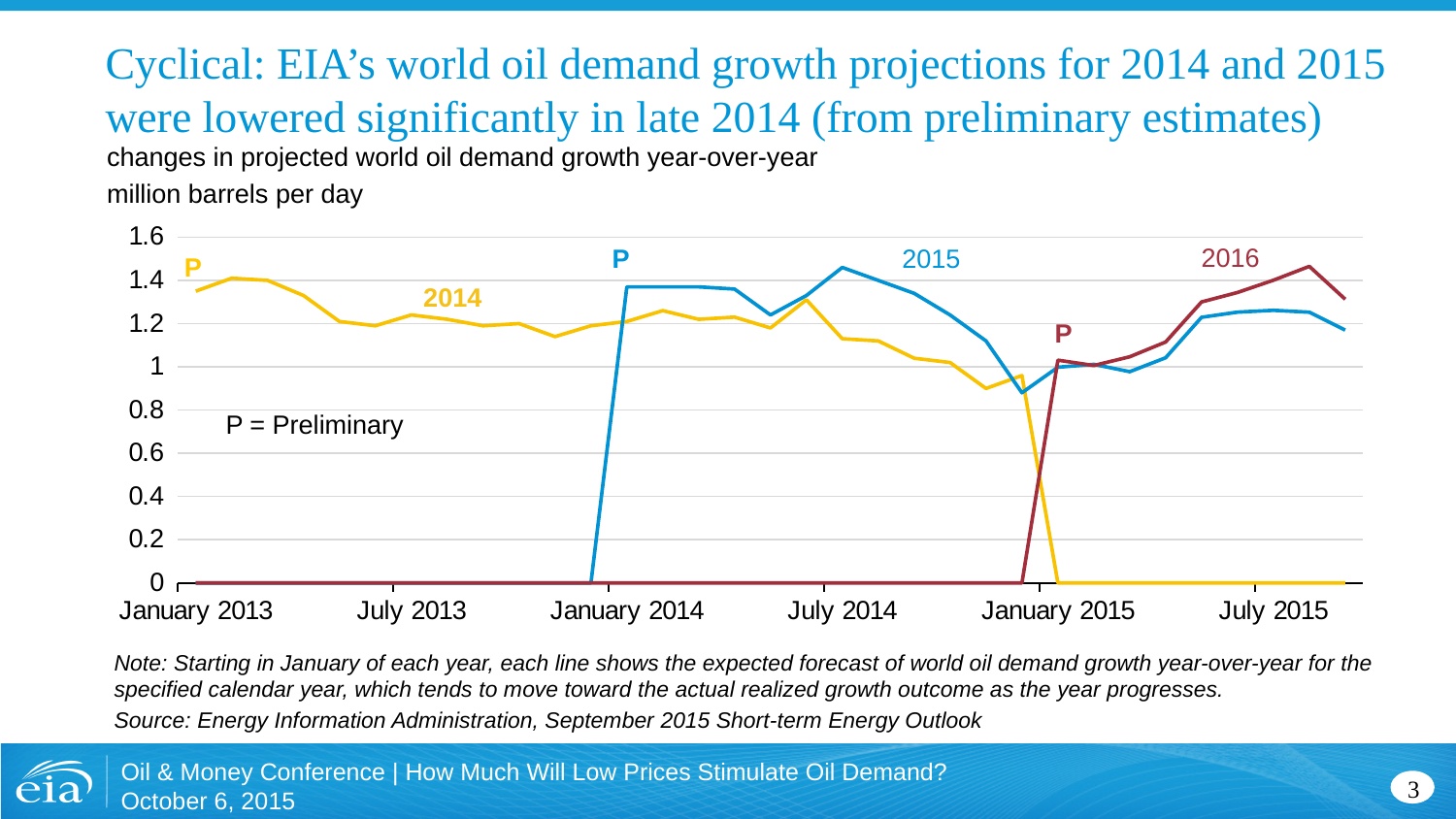
What unit is the y axis of the chart measured in? million barrels per day Is the value of the 2015 line at July 2014 greater or less than 1.2? greater Is the value of the 2014 line at July 2013 greater or less than 1.4? less At July 2014, which line has the higher value, 2014 or 2015? 2015 Is the value of the 2016 line at July 2015 greater or less than 1.2? greater How many series (lines) are plotted on the chart? 3 At January 2014, which line has the higher value, 2014 or 2015? 2015 Does the 2016 line rise or fall between January 2015 and July 2015? rise Does the 2015 line rise or fall between July 2014 and January 2015? fall Which years are the three lines on the chart labeled with? 2014, 2015 and 2016 What kind of chart is shown on the slide? line chart